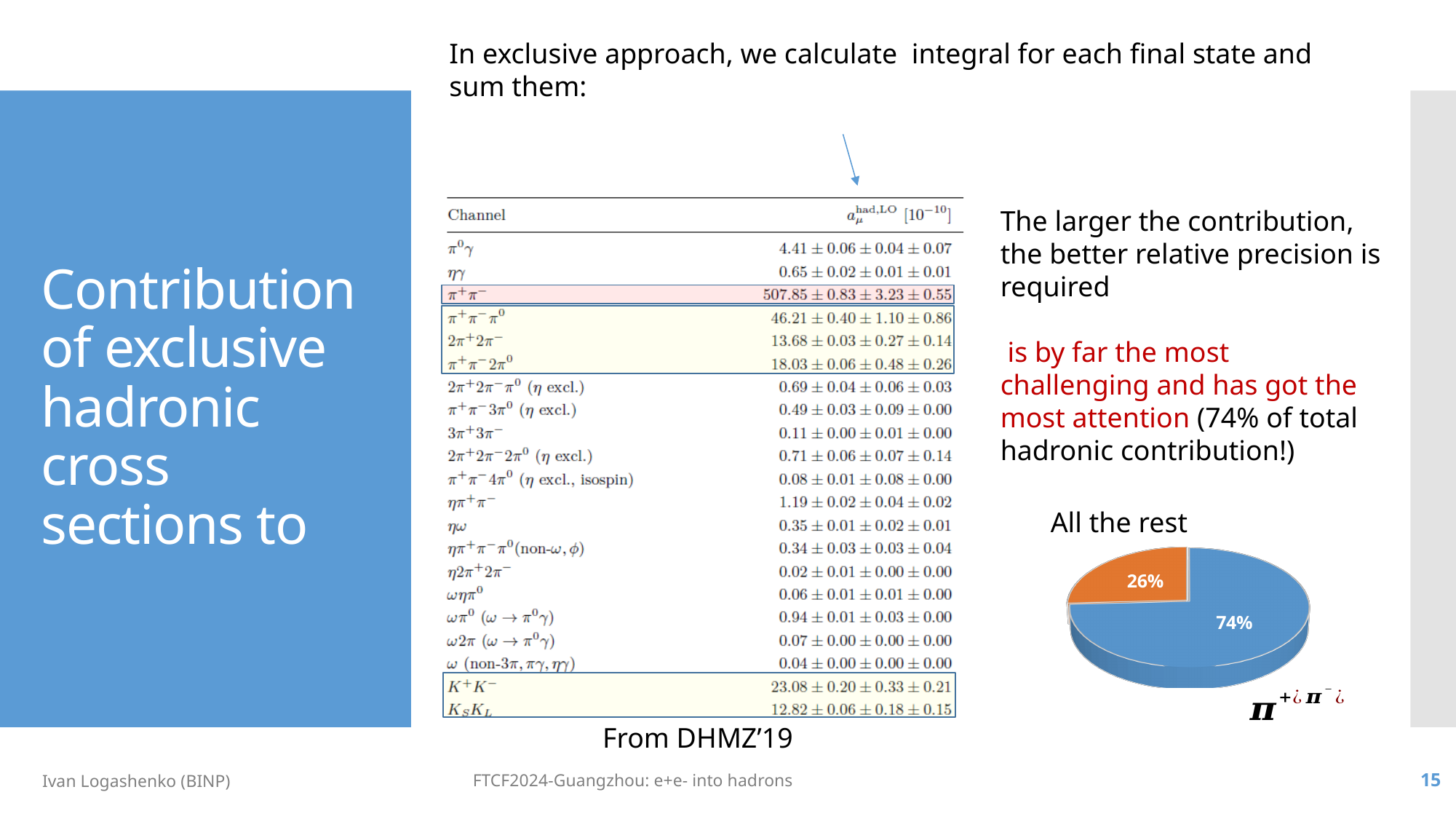
How many slices does the pie chart have? 2 What is the difference in percentage points between the two slices of the pie chart? 48 Which slice of the pie chart is the smallest? All the rest (26%) What kind of chart is shown on the slide? pie chart What is the total of the two slices shown in the pie chart? 100% What share of the pie chart is labelled "All the rest"? 26% Which is larger in the pie chart: the blue slice or the "All the rest" slice? the blue slice What share of the pie chart does the blue slice represent? 74% Which slice of the pie chart is the largest? the blue slice (74%) What colour is the "All the rest" slice in the pie chart? orange Is the share of the blue slice in the pie chart greater or less than 50%? greater